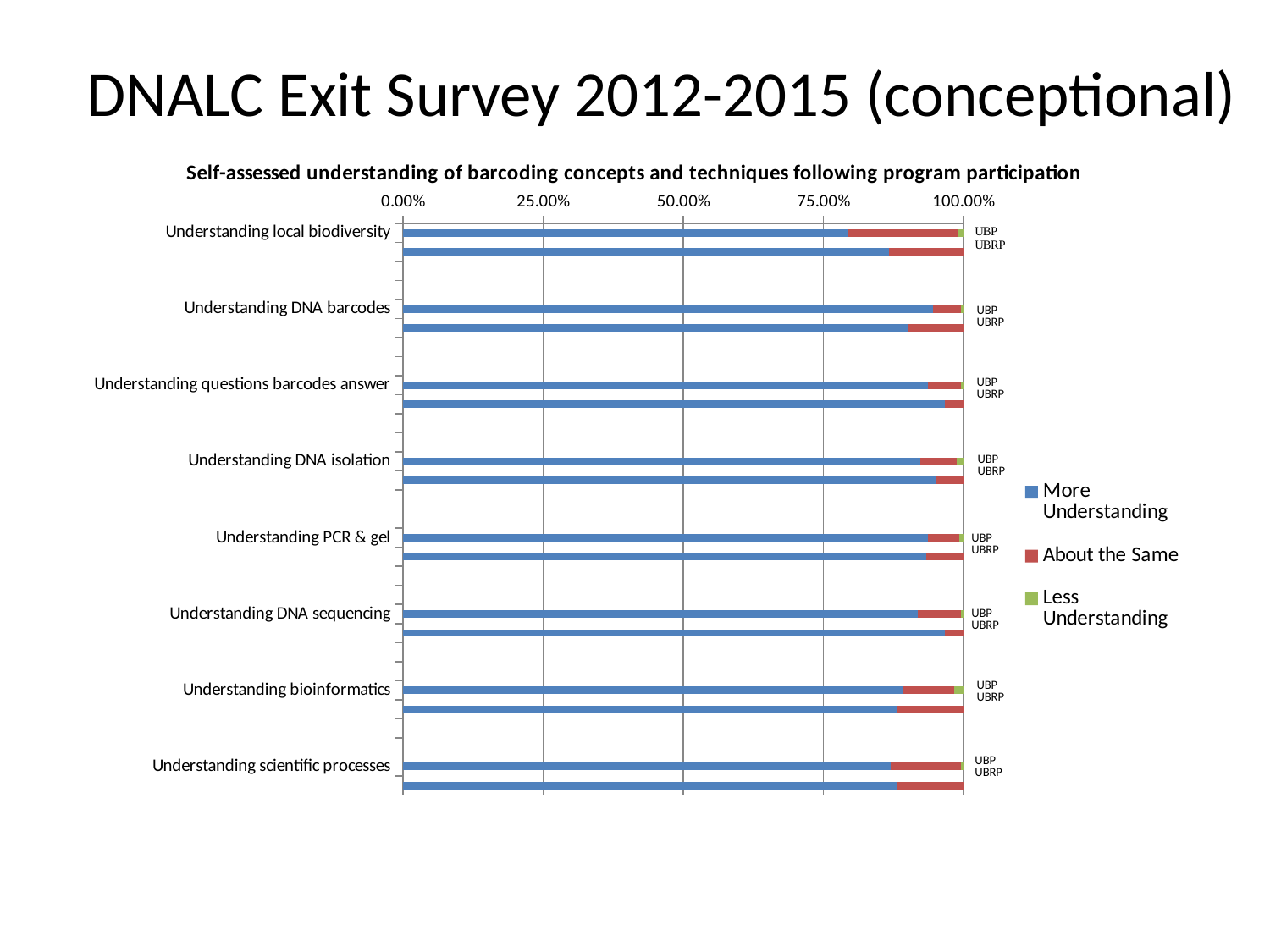
How many series does the legend list? 3 Among the UBP bars, which category has the lowest More Understanding share? Understanding local biodiversity Is the More Understanding value for the UBRP bar of Understanding DNA barcodes greater or less than 75.00%? greater Is the More Understanding value for the UBP bar of Understanding bioinformatics greater or less than 50.00%? greater For Understanding local biodiversity, which bar has the larger More Understanding share, UBP or UBRP? UBRP Is the About the Same value for the UBP bar of Understanding local biodiversity greater or less than 25.00%? less Which series is shown in green in the legend? Less Understanding What is the title of the chart? Self-assessed understanding of barcoding concepts and techniques following program participation Among the UBP bars, which category has the largest About the Same share? Understanding local biodiversity How many understanding categories are listed on the vertical axis? 8 What kind of chart is shown on the slide? Stacked bar chart